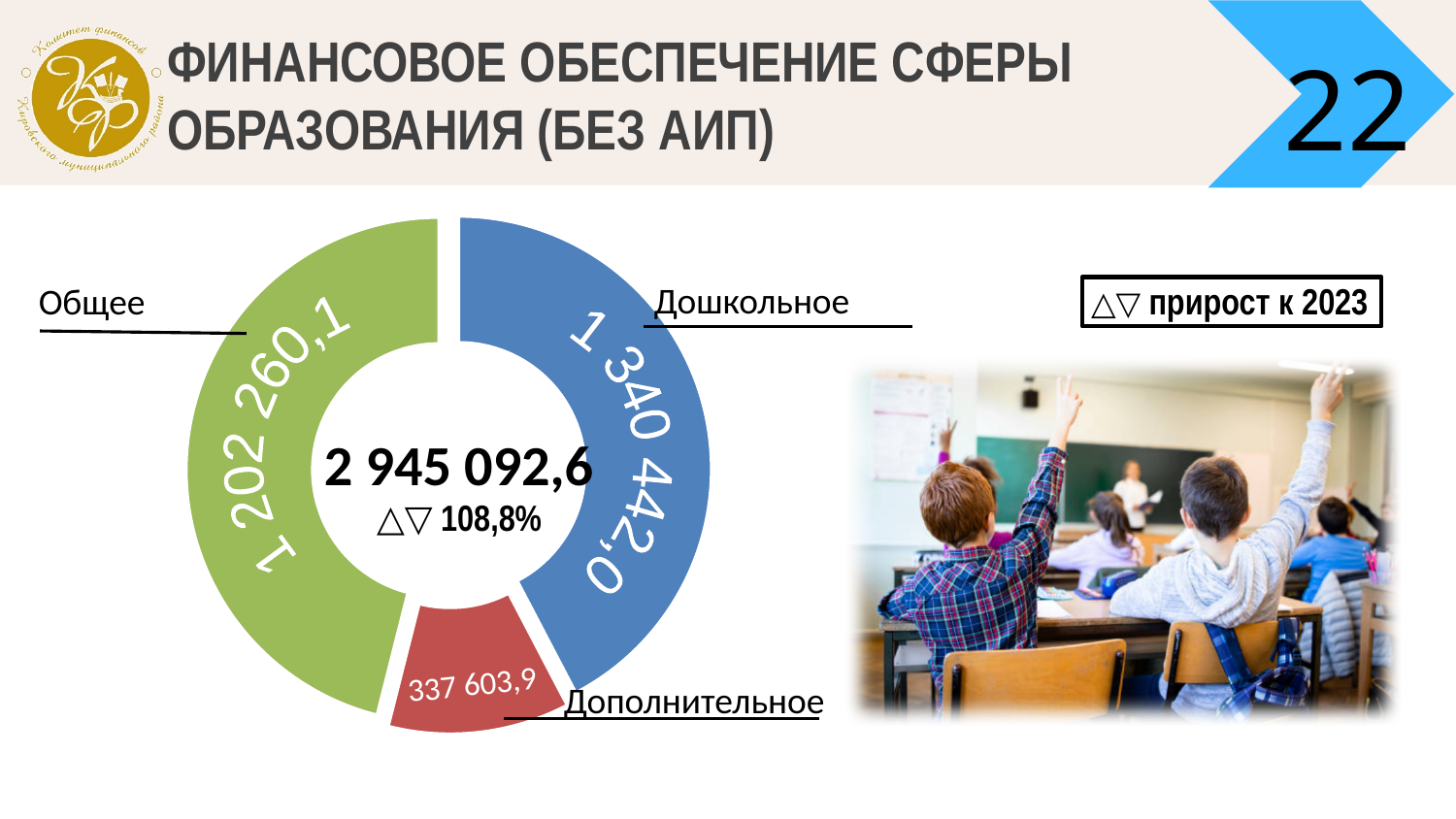
What growth percentage relative to 2023 is shown in the centre of the chart? 108,8% Which segment has the largest value? Дошкольное What total value is shown in the centre of the doughnut chart? 2 945 092,6 What is the value for Дополнительное? 337 603,9 Which is larger, Дошкольное or Общее? Дошкольное What is the value for Общее? 1 202 260,1 How many segments does the doughnut chart have? 3 What is the difference between Дошкольное and Общее? 138 181,9 What is the value for Дошкольное? 1 340 442,0 What type of chart is shown on the slide? Doughnut (pie) chart What is the difference between Общее and Дополнительное? 864 656,2 Which segment has the smallest value? Дополнительное